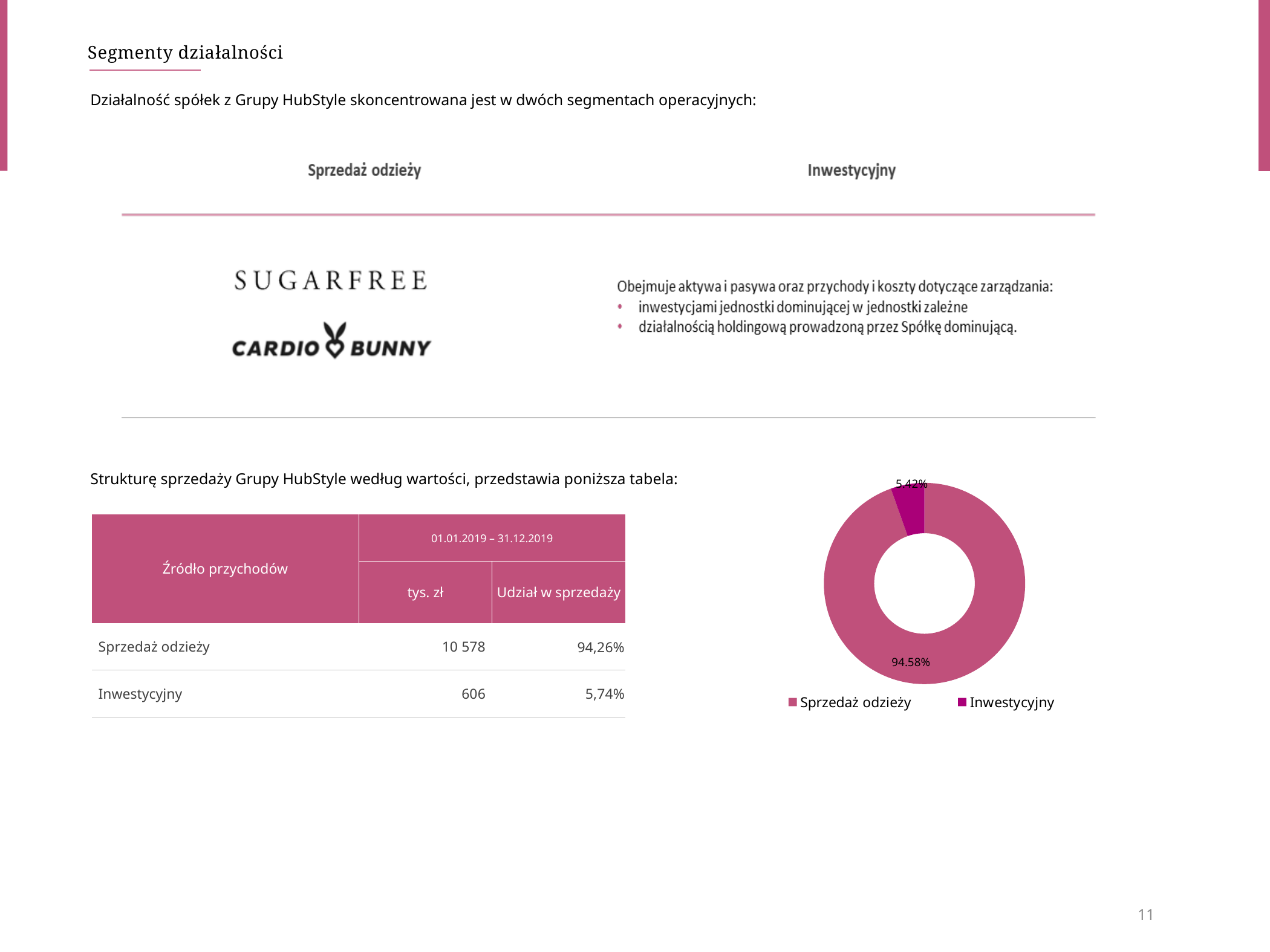
Which segment has the largest slice in the doughnut chart? Sprzedaż odzieży What share does Sprzedaż odzieży have in the doughnut chart? 94.58% How many slices does the doughnut chart have? 2 What is the difference in percentage points between the Sprzedaż odzieży and Inwestycyjny slices in the doughnut chart? 89.16 Which legend entry of the doughnut chart is shown in the darker magenta colour? Inwestycyjny How many entries does the legend of the doughnut chart list? 2 What are the two legend entries of the doughnut chart? Sprzedaż odzieży, Inwestycyjny What kind of chart is shown on the slide? doughnut chart What share does Inwestycyjny have in the doughnut chart? 5.42% In the doughnut chart, which is larger: Sprzedaż odzieży or Inwestycyjny? Sprzedaż odzieży Which segment has the smallest slice in the doughnut chart? Inwestycyjny